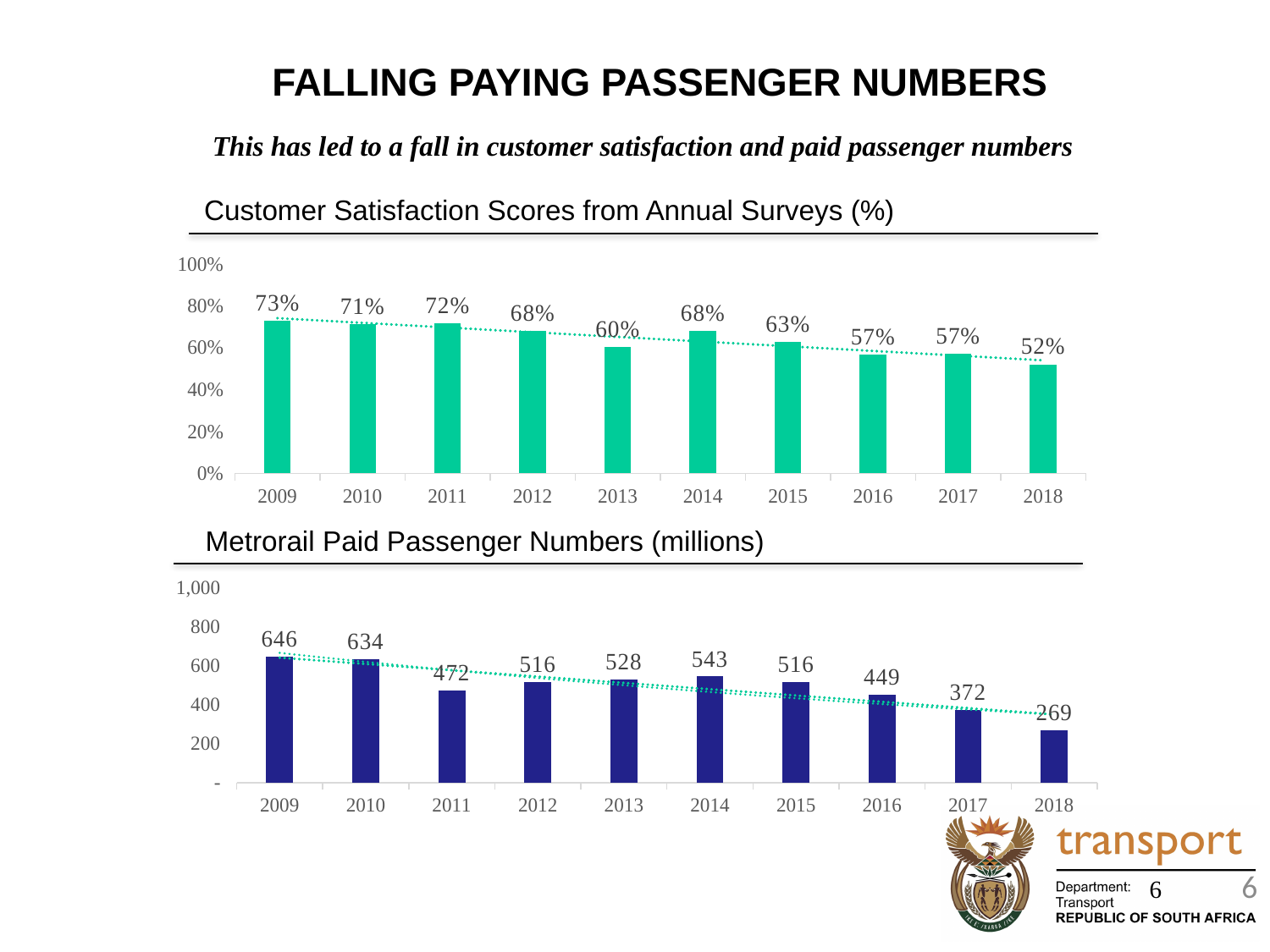
In the Customer Satisfaction Scores chart, do the scores generally rise or fall from 2009 to 2018? fall In the Customer Satisfaction Scores chart, what was the satisfaction score in 2013? 60% In the Customer Satisfaction Scores chart, what is the difference between the 2009 score and the 2018 score? 21% In the Customer Satisfaction Scores chart, which year had the highest score? 2009 In the Metrorail Paid Passenger Numbers chart, what was the value for 2014? 543 What is the title of the top chart on the slide? Customer Satisfaction Scores from Annual Surveys (%) In the Customer Satisfaction Scores chart, which year had the lowest score? 2018 In the Metrorail Paid Passenger Numbers chart, which year had the lowest passenger number? 2018 In the Customer Satisfaction Scores chart, how many years are shown on the x axis? 10 What kind of chart is the Metrorail Paid Passenger Numbers chart? bar chart In the Metrorail Paid Passenger Numbers chart, which is larger, the value for 2011 or the value for 2012? 2012 In the Metrorail Paid Passenger Numbers chart, what is the difference between the 2009 value and the 2010 value? 12